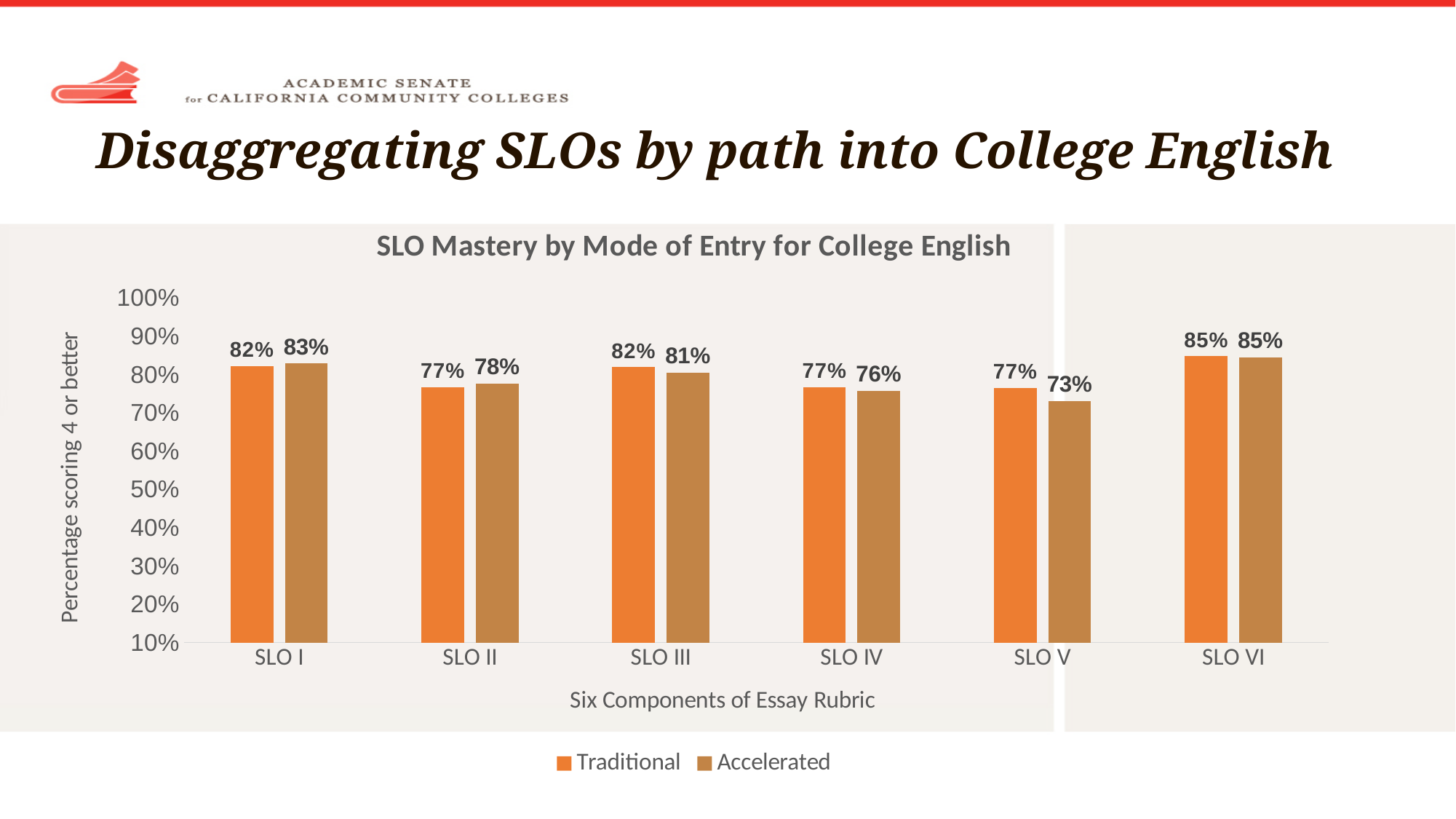
How many SLO categories are shown on the x axis? 6 What is the Accelerated value for SLO V? 73% What is the Traditional value for SLO I? 82% What is the title of the chart? SLO Mastery by Mode of Entry for College English What kind of chart is shown on the slide? bar chart Which SLO has the lowest Accelerated value? SLO V Which SLO has the highest Traditional value? SLO VI How many series does the legend list? 2 What is the Accelerated value for SLO II? 78% For SLO III, which is larger: the Traditional or the Accelerated value? Traditional Is the Accelerated value for SLO IV greater or less than 80%? less What is the difference between the Traditional and Accelerated values for SLO V? 4%